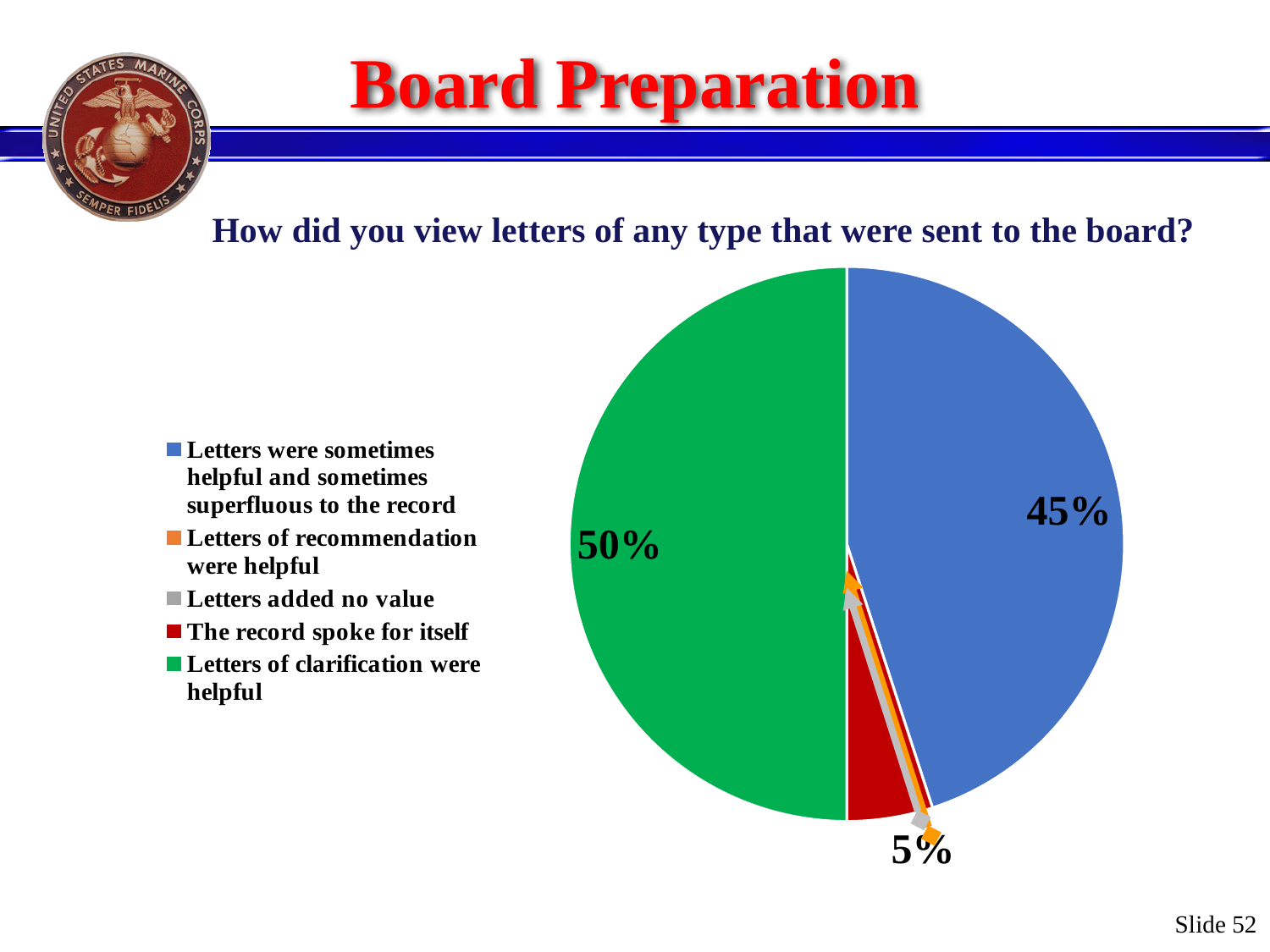
What question does the chart answer, according to the heading above it? How did you view letters of any type that were sent to the board? Which response has the largest share of the pie? Letters of clarification were helpful Which is larger: the share for "Letters of clarification were helpful" or the share for "Letters were sometimes helpful and sometimes superfluous to the record"? Letters of clarification were helpful What kind of chart is shown on the slide? Pie chart What colour is the slice for "The record spoke for itself"? Red What is the difference between the share for "Letters of clarification were helpful" and the share for "Letters were sometimes helpful and sometimes superfluous to the record"? 5% What is the difference between the share for "Letters were sometimes helpful and sometimes superfluous to the record" and the share for "The record spoke for itself"? 40% What percentage is shown for "Letters were sometimes helpful and sometimes superfluous to the record"? 45% What share of the pie is labelled for "Letters of clarification were helpful"? 50% What percentage is shown for "The record spoke for itself"? 5% How many entries does the legend list? 5